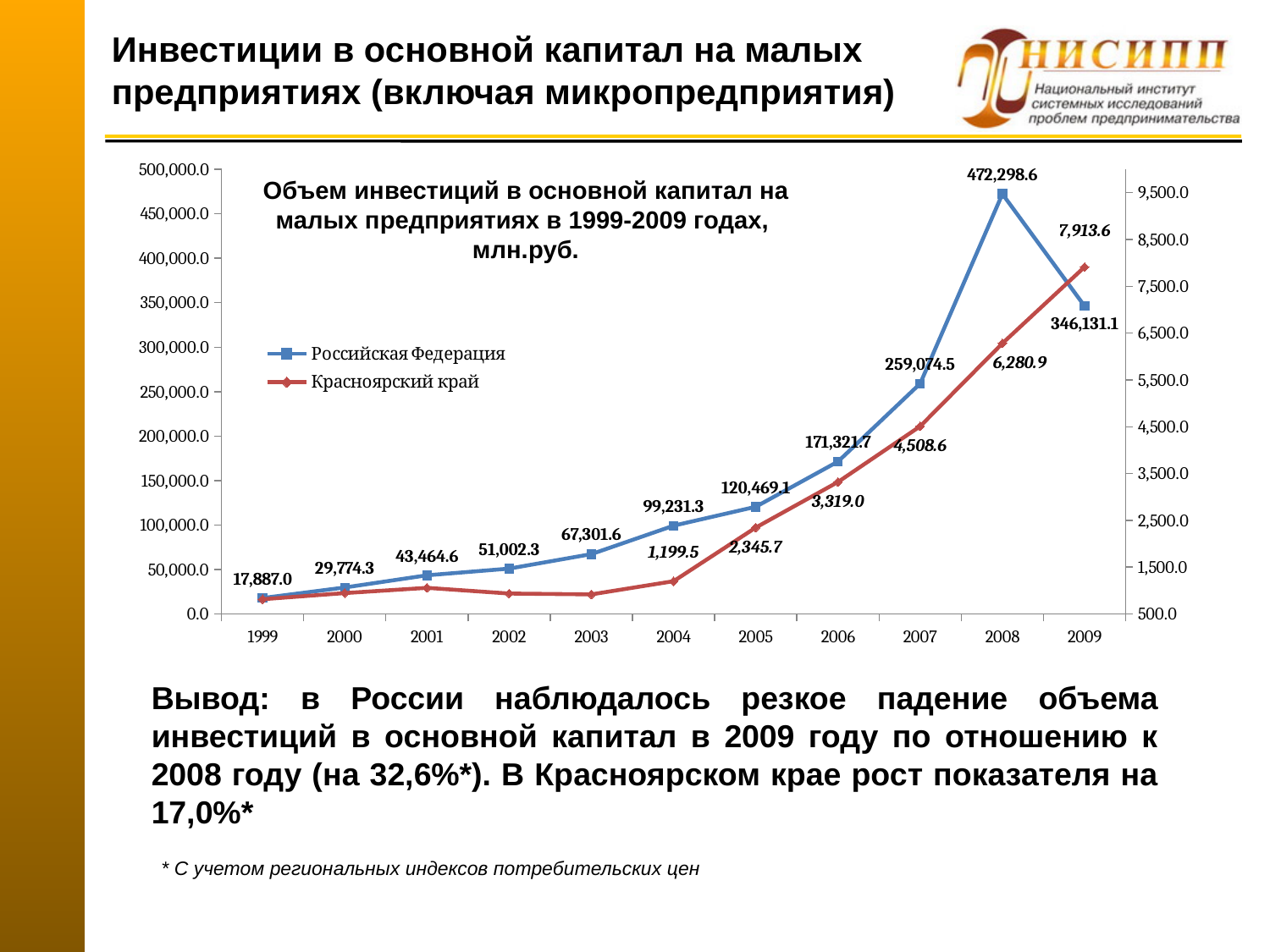
In which year is the Российская Федерация series at its lowest value? 1999 How many series does the legend list? 2 What is the value for the Красноярский край series in 2009? 7,913.6 What is the value for the Российская Федерация series in 2008? 472,298.6 What kind of chart is shown on the slide? line chart What is the difference between the Красноярский край values for 2009 and 2008? 1,632.7 Which is larger for the Российская Федерация series: the 2006 value or the 2007 value? 2007 What is the value for the Российская Федерация series in 1999? 17,887.0 How many years are shown on the x axis? 11 Is the value for Красноярский край in 2003 greater or less than 1,500.0 on the right axis? less In which year does the Российская Федерация series reach its highest value? 2008 By how much did the Российская Федерация value fall from 2008 to 2009? 126,167.5